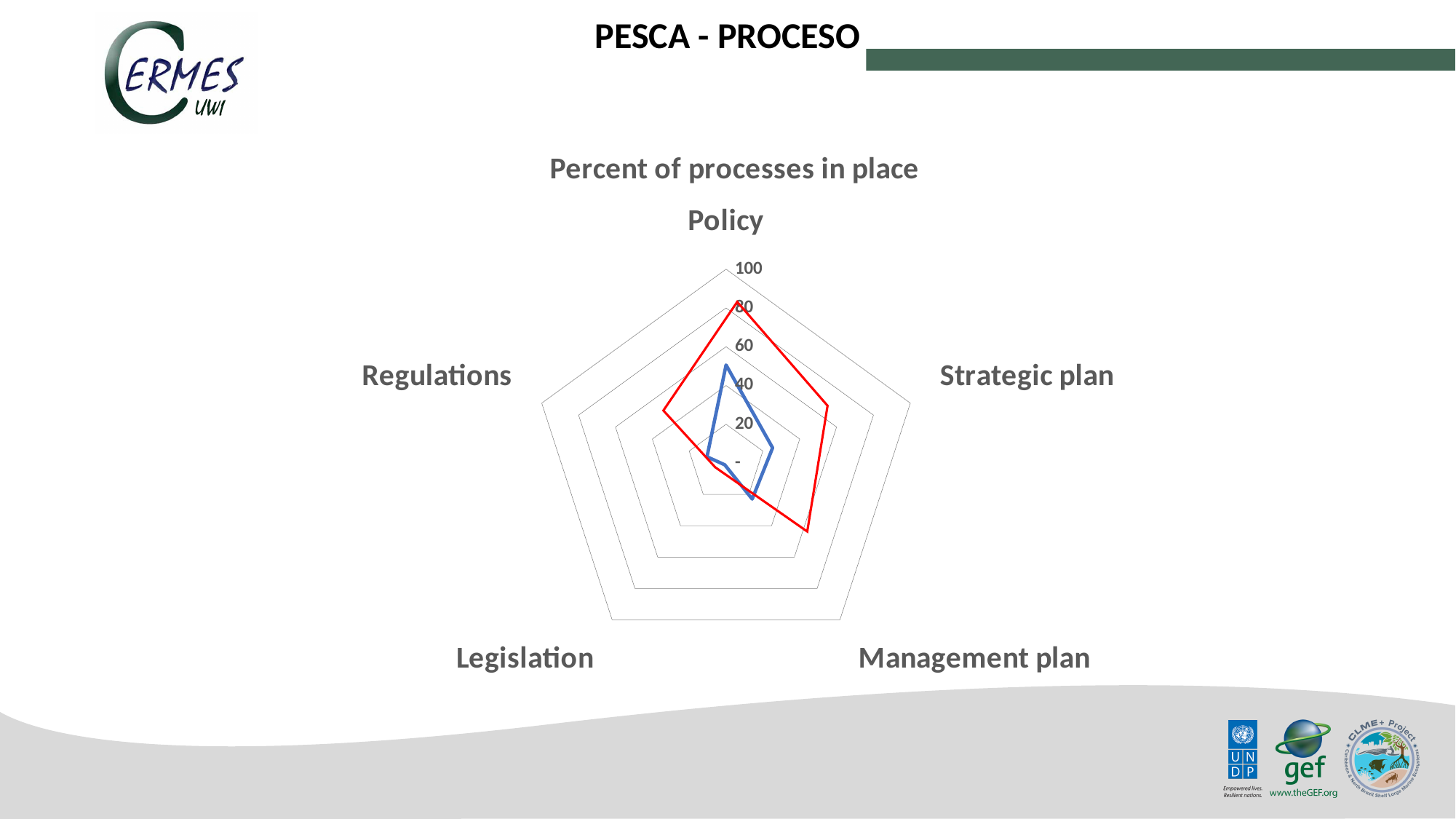
Is the blue series value for Policy greater or less than 60? less What is the title of the chart? Percent of processes in place How many categories (axes) does the radar chart have? 5 Is the blue series value for Legislation greater or less than 20? less Which category has the lowest value for the red series? Legislation What is the highest value shown on the chart's axis scale? 100 Is the red series value for Legislation greater or less than 40? less For Policy, which series has the larger value, the red or the blue? Red What kind of chart is shown on the slide? Radar chart